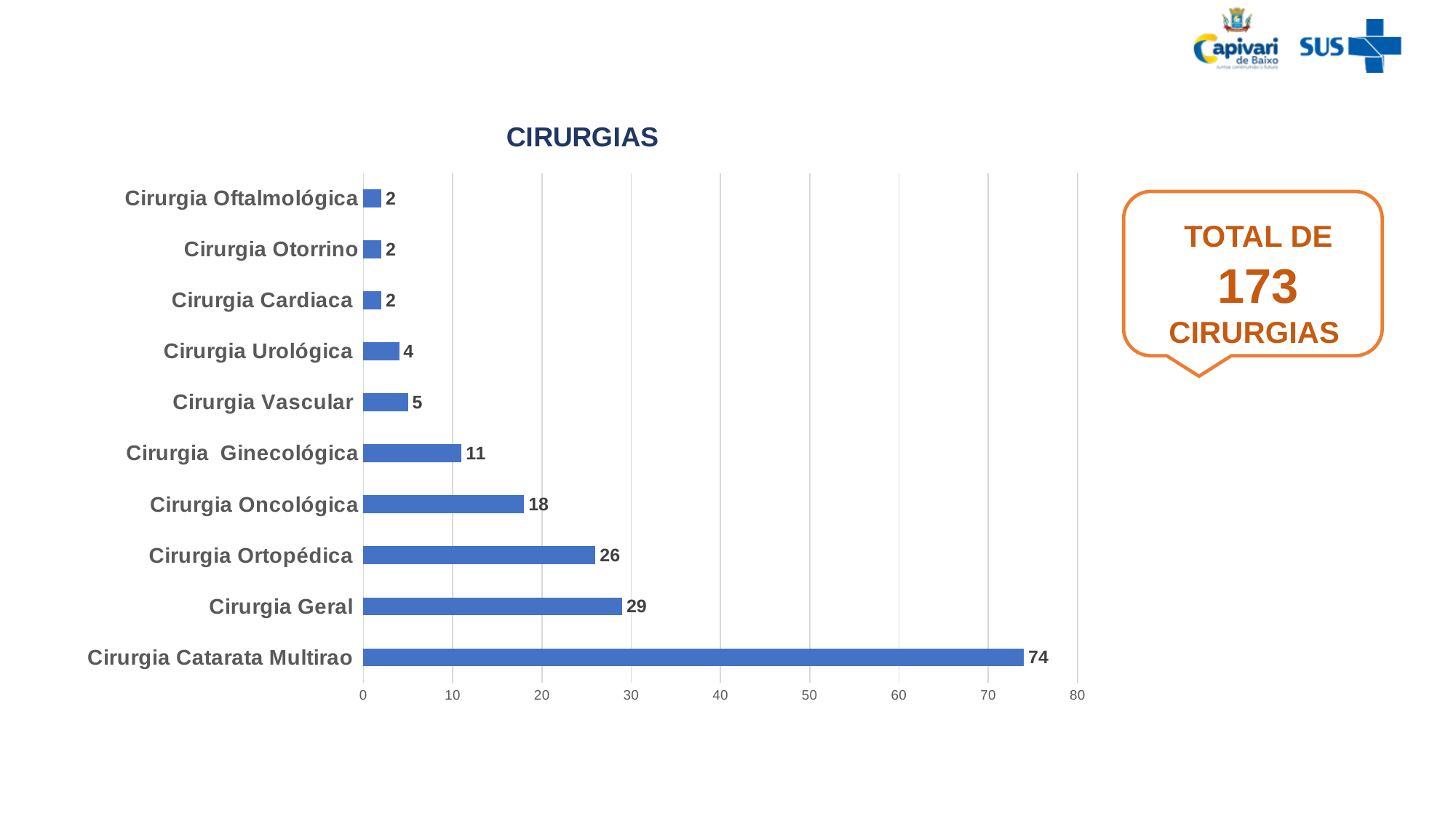
What is the title of the chart? CIRURGIAS Which category has the highest value? Cirurgia Catarata Multirao How many categories are shown in the chart? 10 What is the difference between Cirurgia Catarata Multirao and Cirurgia Geral? 45 What kind of chart is shown on the slide? Bar chart Which is larger, Cirurgia Ortopédica or Cirurgia Oncológica? Cirurgia Ortopédica Is the value for Cirurgia Catarata Multirao greater or less than 70? greater What is the difference between Cirurgia Ortopédica and Cirurgia Ginecológica? 15 What is the value for Cirurgia Geral? 29 What is the value for Cirurgia Oncológica? 18 What is the value for Cirurgia Catarata Multirao? 74 What is the value for Cirurgia Vascular? 5